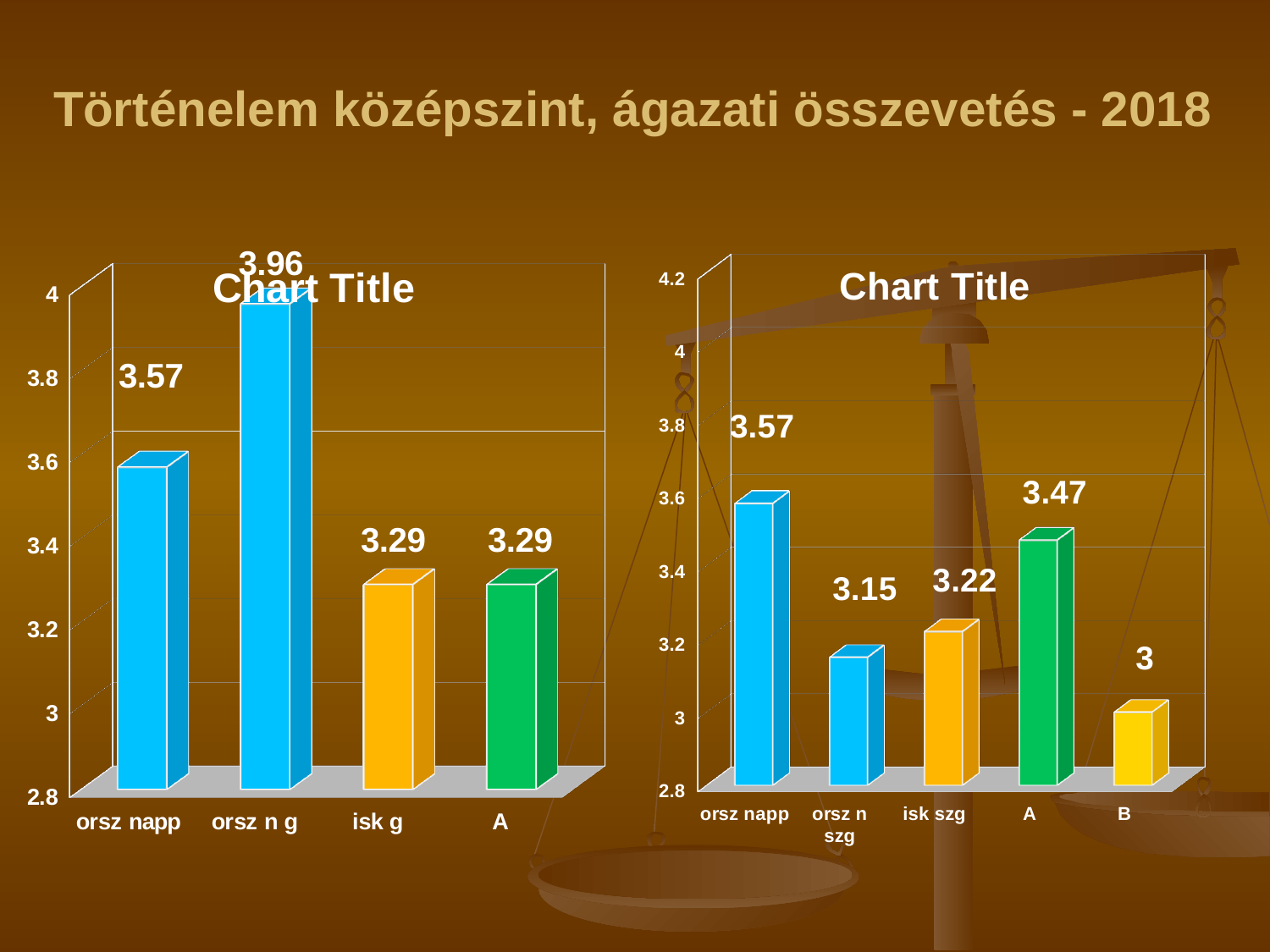
In the left chart, which category has the highest value? orsz n g What type of chart is the right chart? bar chart In the left chart, what is the value for isk g? 3.29 In the left chart, what is the difference between orsz n g and orsz napp? 0.39 In the right chart, which category has the highest value? orsz napp In the right chart, which category has the lowest value? B In the left chart, what is the value for orsz n g? 3.96 In the right chart, what is the value for B? 3 In the left chart, how many bars are there? 4 In the right chart, which is larger, A or orsz n szg? A In the right chart, what is the difference between orsz napp and orsz n szg? 0.42 In the right chart, what is the value for isk szg? 3.22